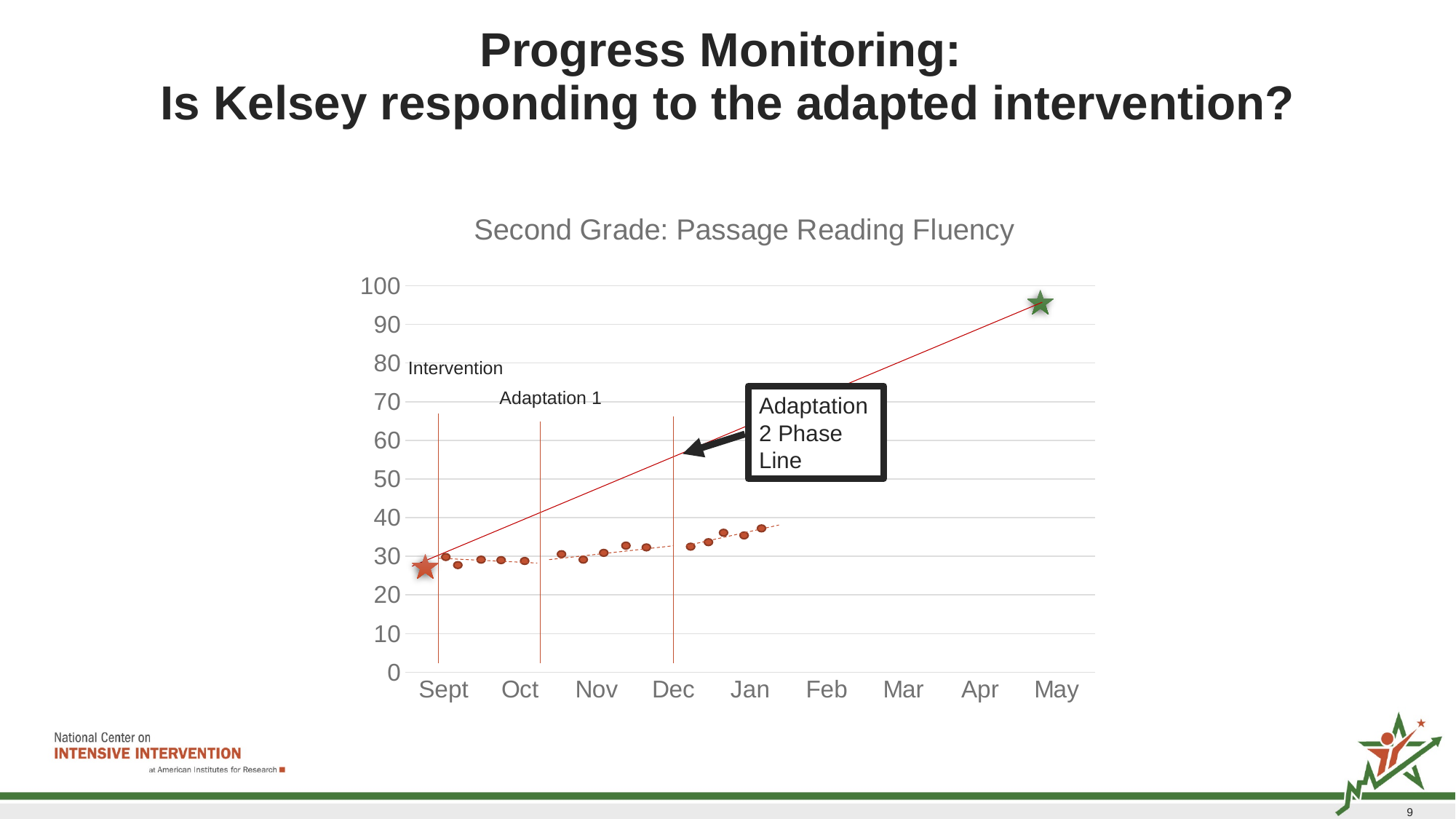
Which is higher, the green goal star in May or the plotted data points in Jan? the green goal star in May Are the plotted data points in Oct greater or less than 40? less Is the value of the green goal star in May greater or less than 90? greater What is the first month labelled on the x axis? Sept What is the title of the chart? Second Grade: Passage Reading Fluency What is the last month labelled on the x axis? May Are the plotted data points in Jan greater or less than 40? less How many months are labelled on the x axis of the chart? 9 Do the plotted data points generally rise or fall from Sept to Jan? rise